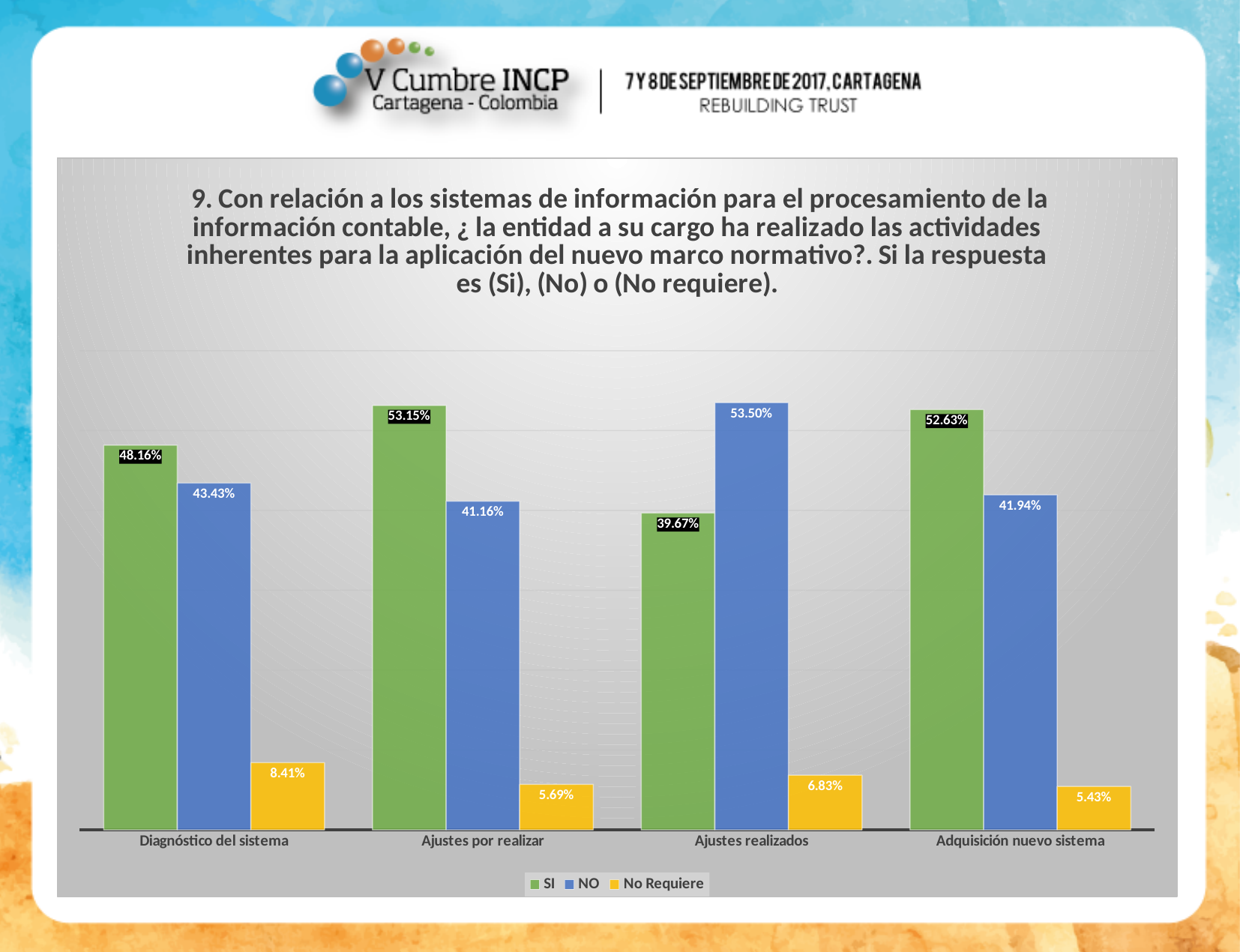
Which category has the lowest No Requiere value? Adquisición nuevo sistema What is the NO value for Ajustes por realizar? 41.16% What is the difference between the SI and NO values for Ajustes realizados? 13.83% What is the No Requiere value for Adquisición nuevo sistema? 5.43% Which is larger for Diagnóstico del sistema, the SI value or the NO value? SI Which category has the highest SI value? Ajustes por realizar How many categories are shown on the x axis? 4 What kind of chart is shown on the slide? Bar chart What is the SI value for Diagnóstico del sistema? 48.16% What is the NO value for Ajustes realizados? 53.50% Which colour represents the No Requiere series? Yellow How many series does the legend list? 3